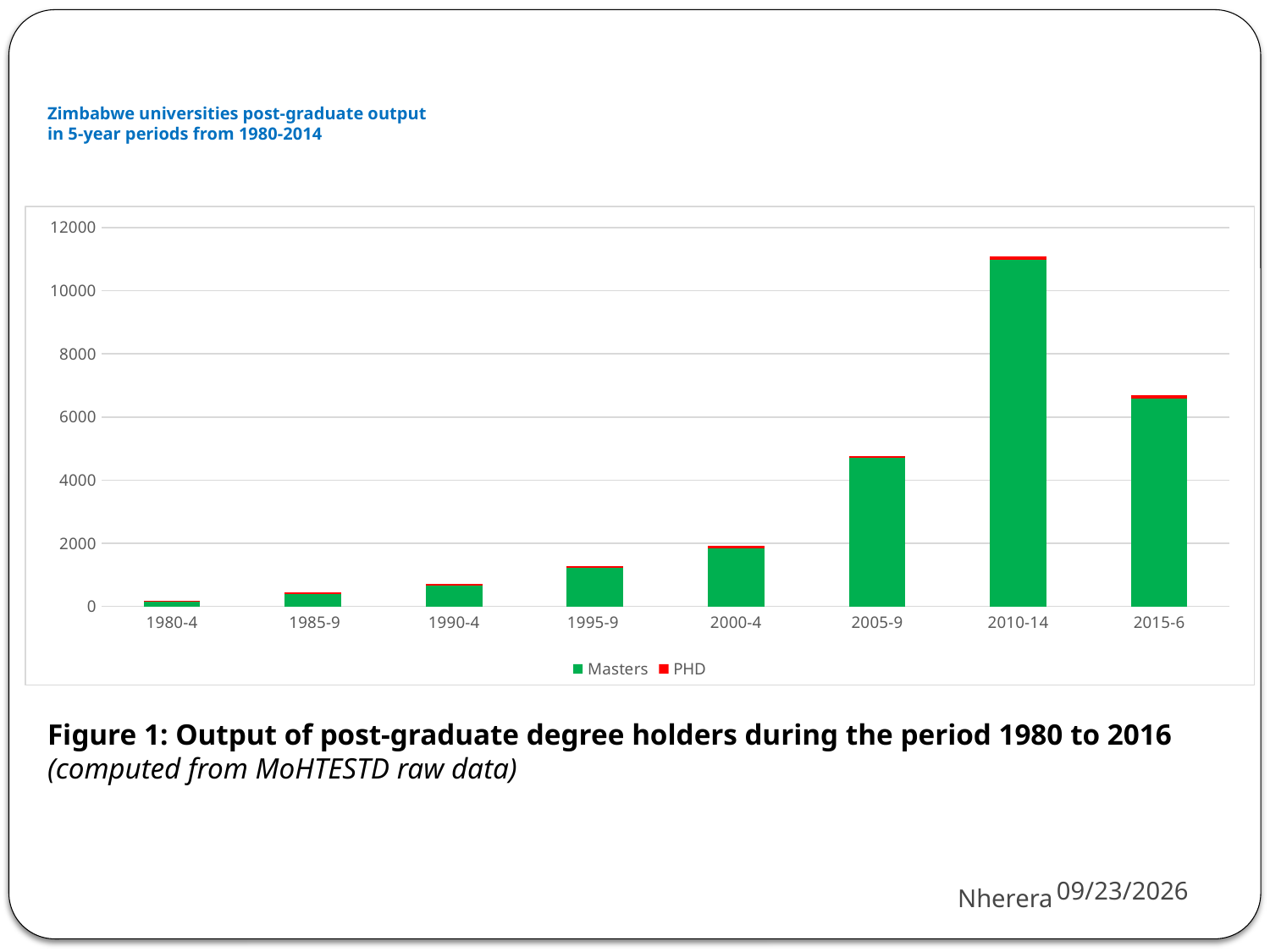
Which period has the highest total post-graduate output? 2010-14 Is the total value for 2015-6 greater or less than 6000? greater Is the total value for 2005-9 greater or less than 4000? greater Which series is shown in green in the chart? Masters What kind of chart is shown on the slide? Stacked bar chart Which period has a larger total output, 2005-9 or 2015-6? 2015-6 Which period has the lowest total post-graduate output? 1980-4 Is the total value for 1990-4 greater or less than 1000? less From 1980-4 to 2010-14, do the total values rise or fall along the x axis? rise How many series does the chart's legend list? 2 How many time periods are shown on the x axis of the chart? 8